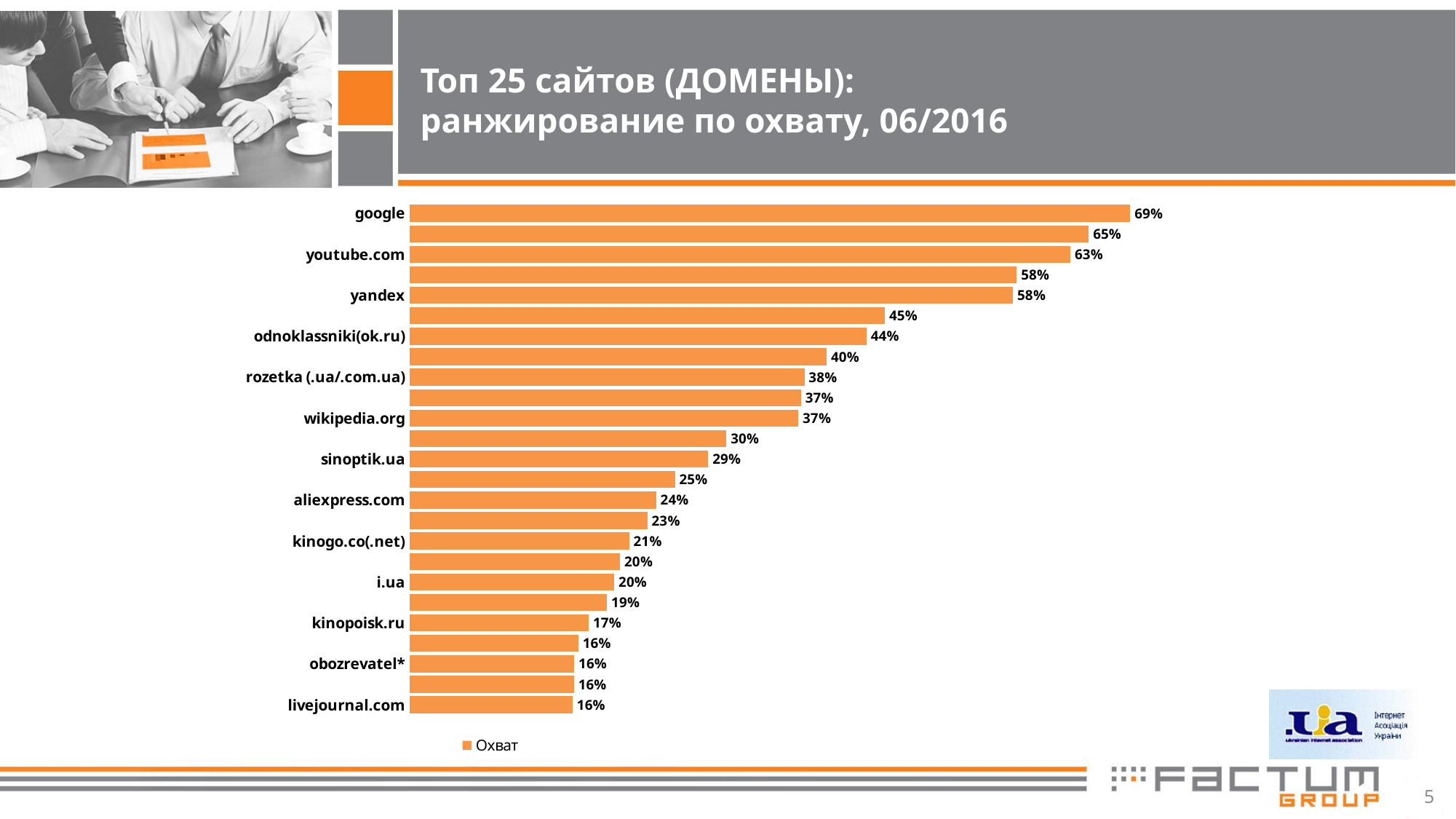
What is the difference between the values for google and yandex? 11% What kind of chart is shown on the slide? bar chart Which is larger, the value for rozetka (.ua/.com.ua) or the value for i.ua? rozetka (.ua/.com.ua) What is the value for odnoklassniki(ok.ru)? 44% How many series does the legend list? 1 What is the value for youtube.com? 63% What is the value for sinoptik.ua? 29% Which labeled site has the highest value? google What is the value for google? 69% How many bars are plotted in the chart? 25 What is the value for kinopoisk.ru? 17% What is the difference between the values for wikipedia.org and aliexpress.com? 13%